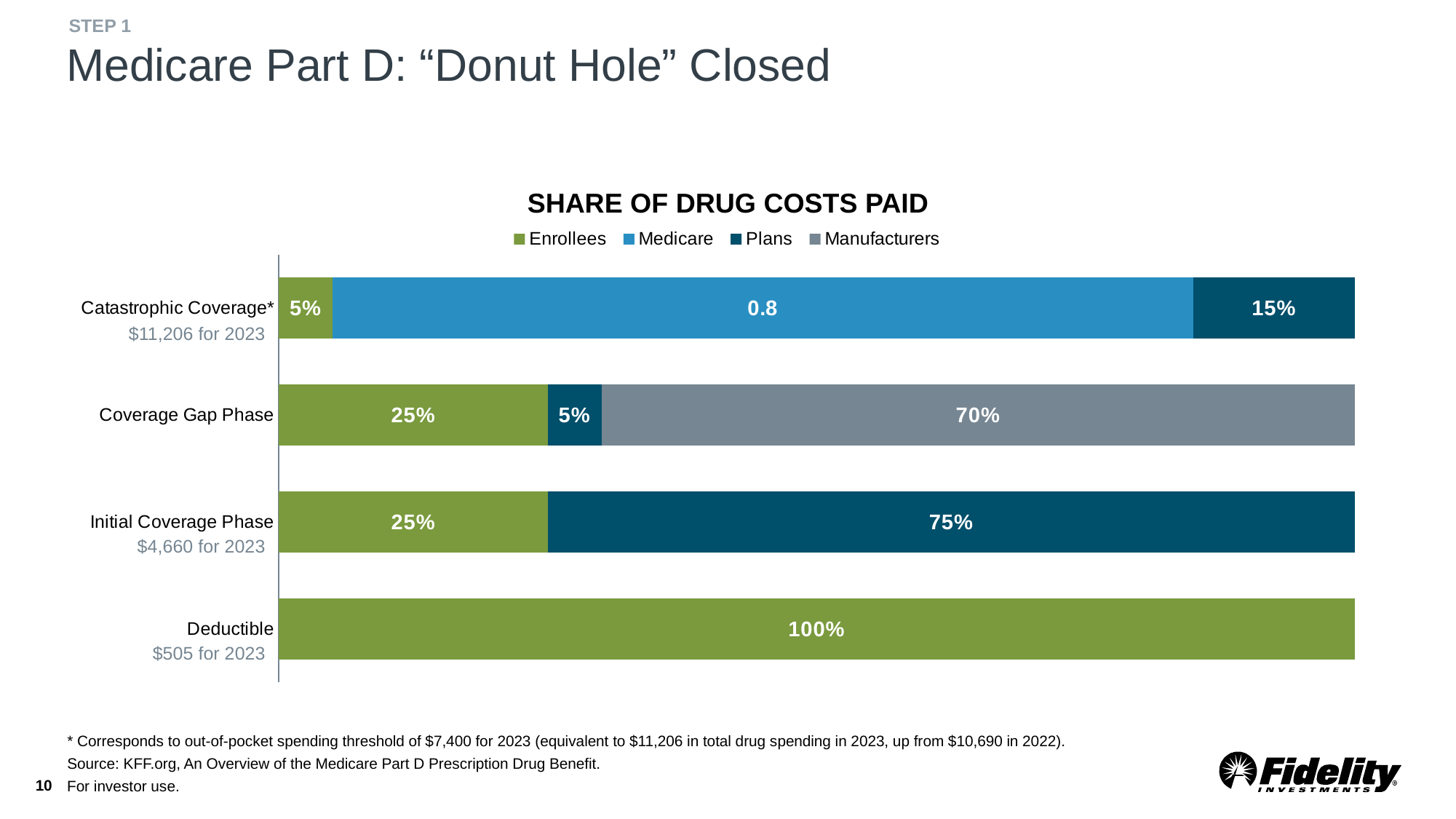
What label is printed on the Medicare segment for Catastrophic Coverage? 0.8 What kind of chart is shown on the slide? Stacked bar chart What is the Manufacturers share of drug costs in the Coverage Gap Phase? 70% How many series does the legend list? 4 How many categories (coverage phases) are shown on the chart? 4 In which phase is the Enrollees share of drug costs highest? Deductible In the Coverage Gap Phase, how many percentage points larger is the Manufacturers share than the Plans share? 65 percentage points What is the title of the chart? SHARE OF DRUG COSTS PAID What is the Enrollees share of drug costs in the Deductible phase? 100% In the Coverage Gap Phase, which pays a larger share: Plans or Manufacturers? Manufacturers What is the Plans share of drug costs in Catastrophic Coverage? 15% What is the Plans share of drug costs in the Initial Coverage Phase? 75%